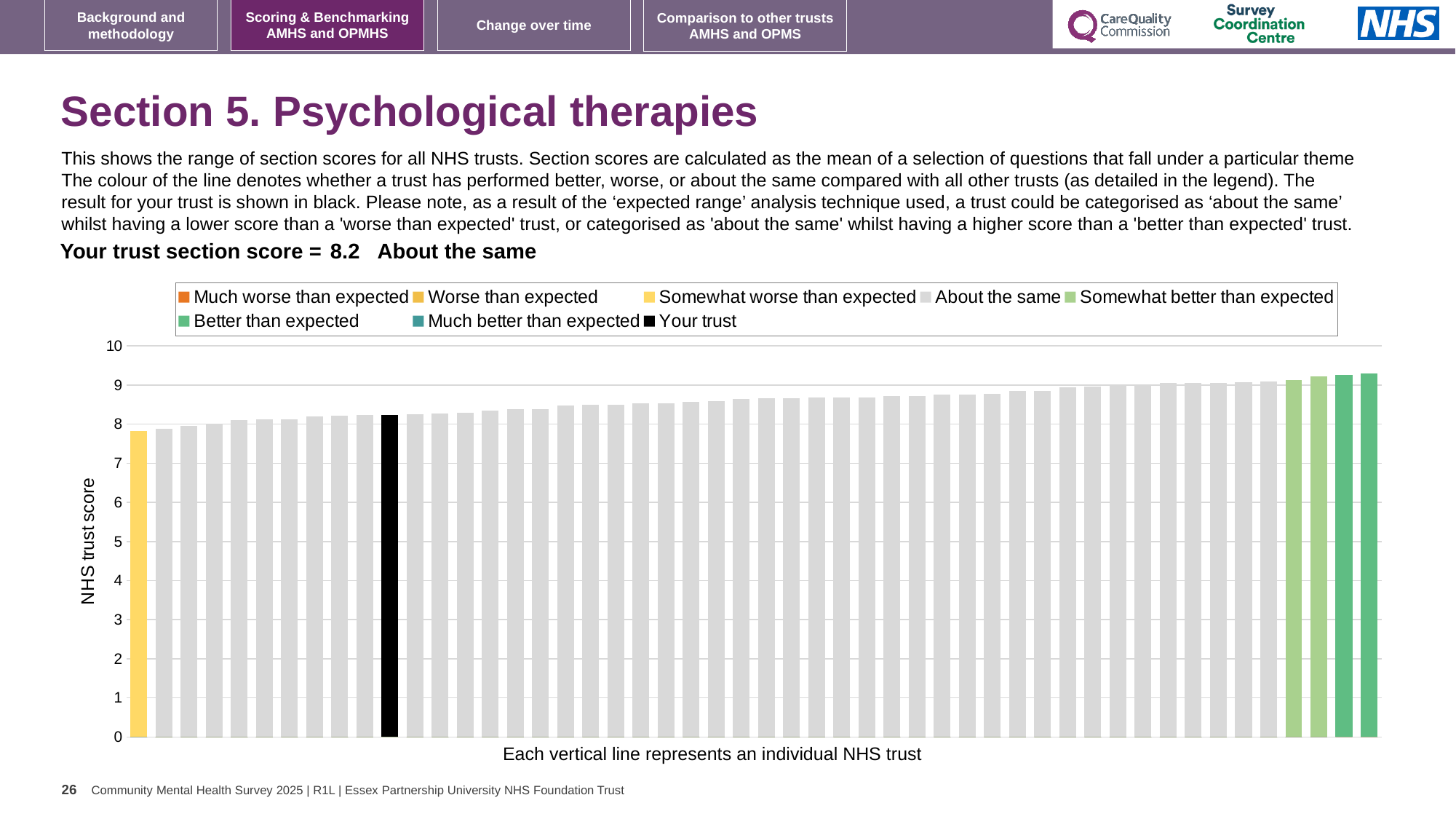
Which benchmarking category is your trust placed in for this section? About the same What is the label on the vertical axis of the chart? NHS trust score How many bars in the chart are coloured green? 4 Which is larger, the leftmost bar or the rightmost bar? the rightmost bar What colour is the bar representing your trust? black Do the bar values rise or fall from left to right along the x axis? rise Is the value of the rightmost bar greater or less than 9? greater Is the value of the black 'Your trust' bar greater or less than 8? greater Is the value of the leftmost bar greater or less than 8? less How many entries does the chart legend list? 8 What kind of chart is shown on the slide? bar chart What is the section score for your trust? 8.2